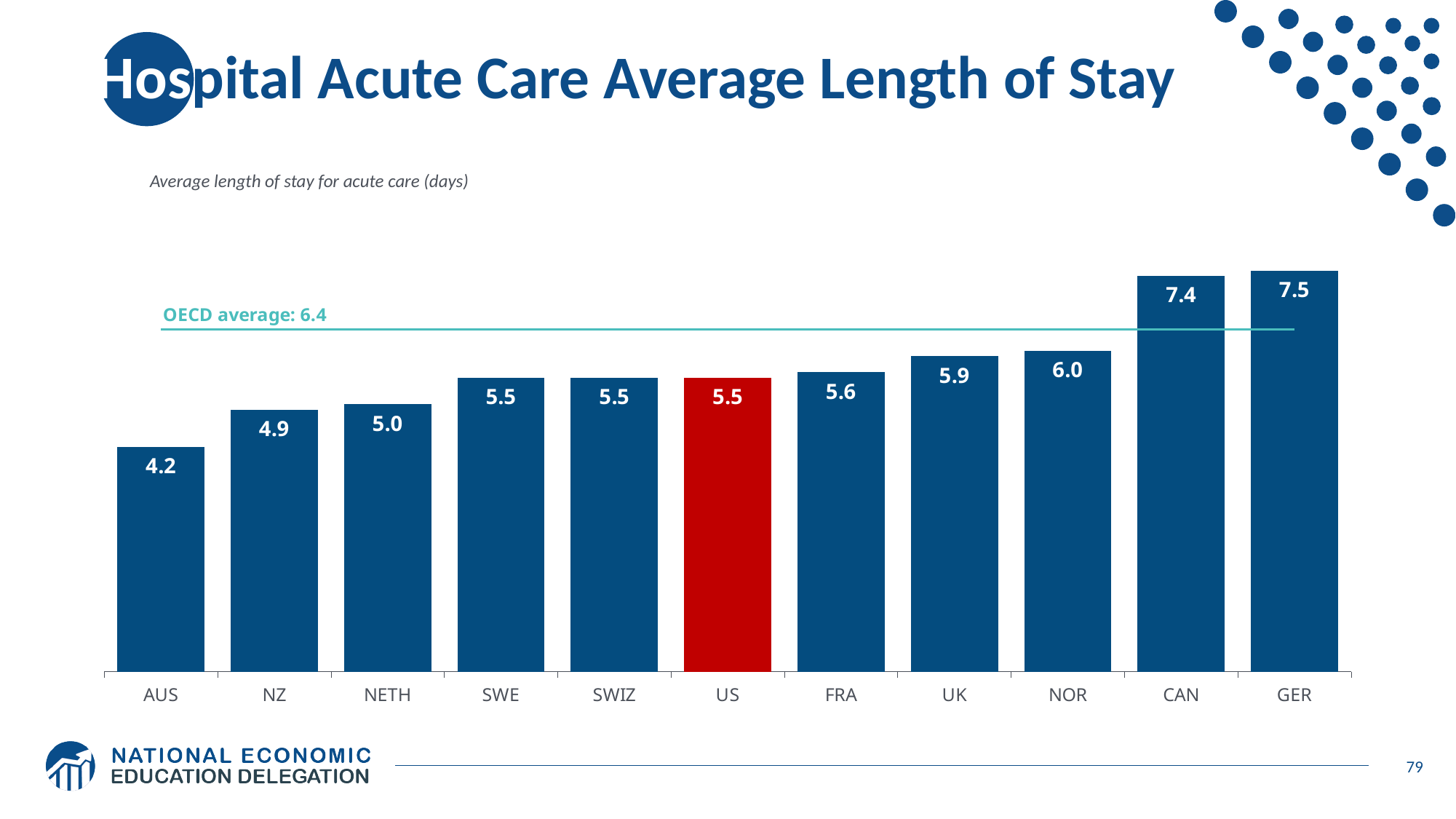
What is the average length of stay for acute care in Germany (GER)? 7.5 What is the average length of stay for acute care in the US? 5.5 Which has a longer average length of stay, NOR or NETH? NOR What type of chart is shown on the slide? Bar chart How many countries are shown in the chart? 11 What is the OECD average shown on the chart? 6.4 What is the difference in average length of stay between CAN and the US? 1.9 What is the value shown for AUS? 4.2 What is the difference in average length of stay between GER and AUS? 3.3 Which country has the lowest average length of stay for acute care? AUS Which country has the highest average length of stay for acute care? GER Which country's bar is highlighted in red? US